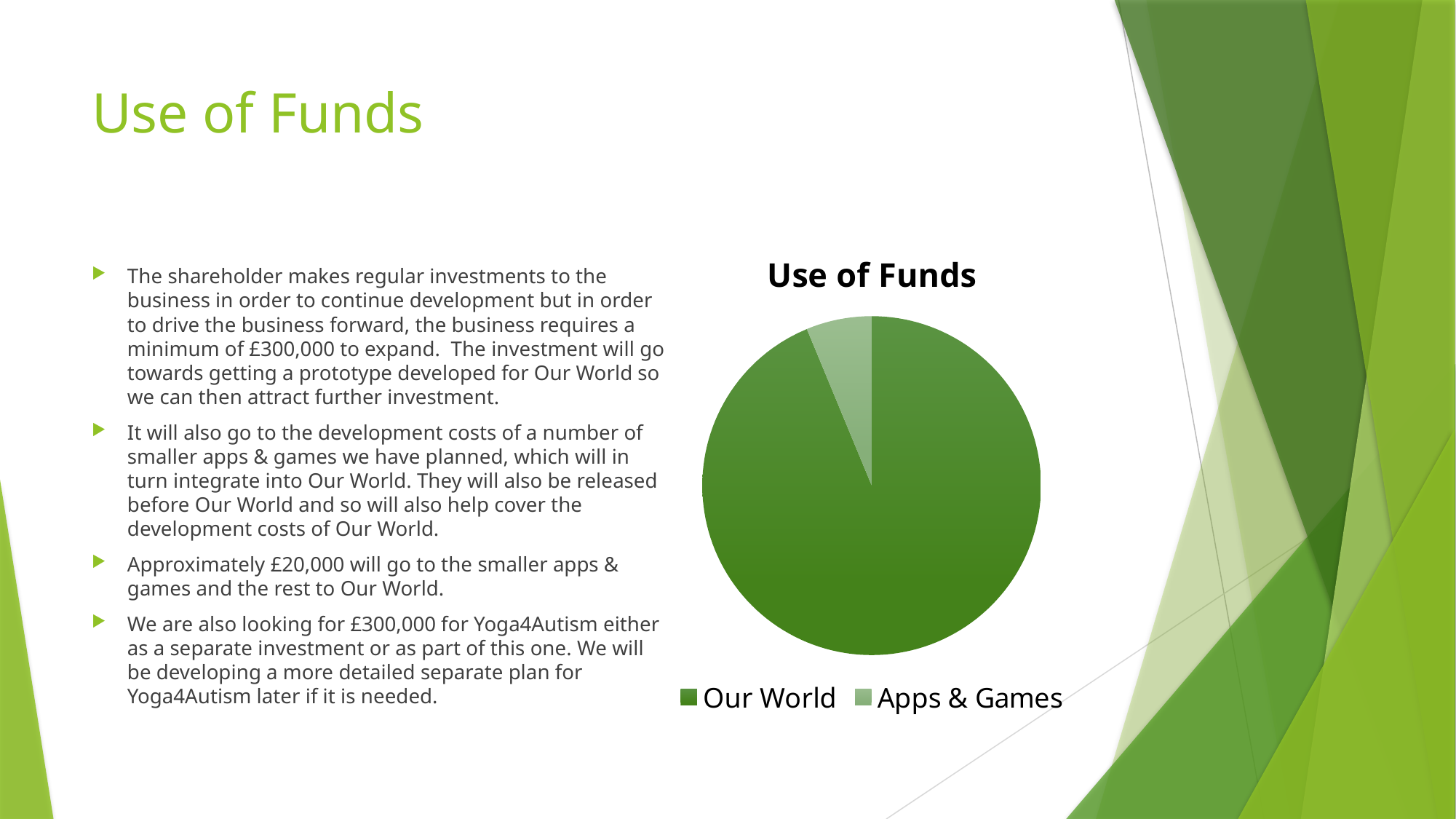
How many slices does the pie chart have? 2 Which category has the largest slice of the pie? Our World What is the title of the chart? Use of Funds How many entries does the chart legend list? 2 Which category is shown in the lighter green colour in the pie chart? Apps & Games Which slice is larger, Our World or Apps & Games? Our World Which category has the smallest slice of the pie? Apps & Games Does the Our World slice take up more or less than half of the pie? more What kind of chart is shown on the slide? pie chart